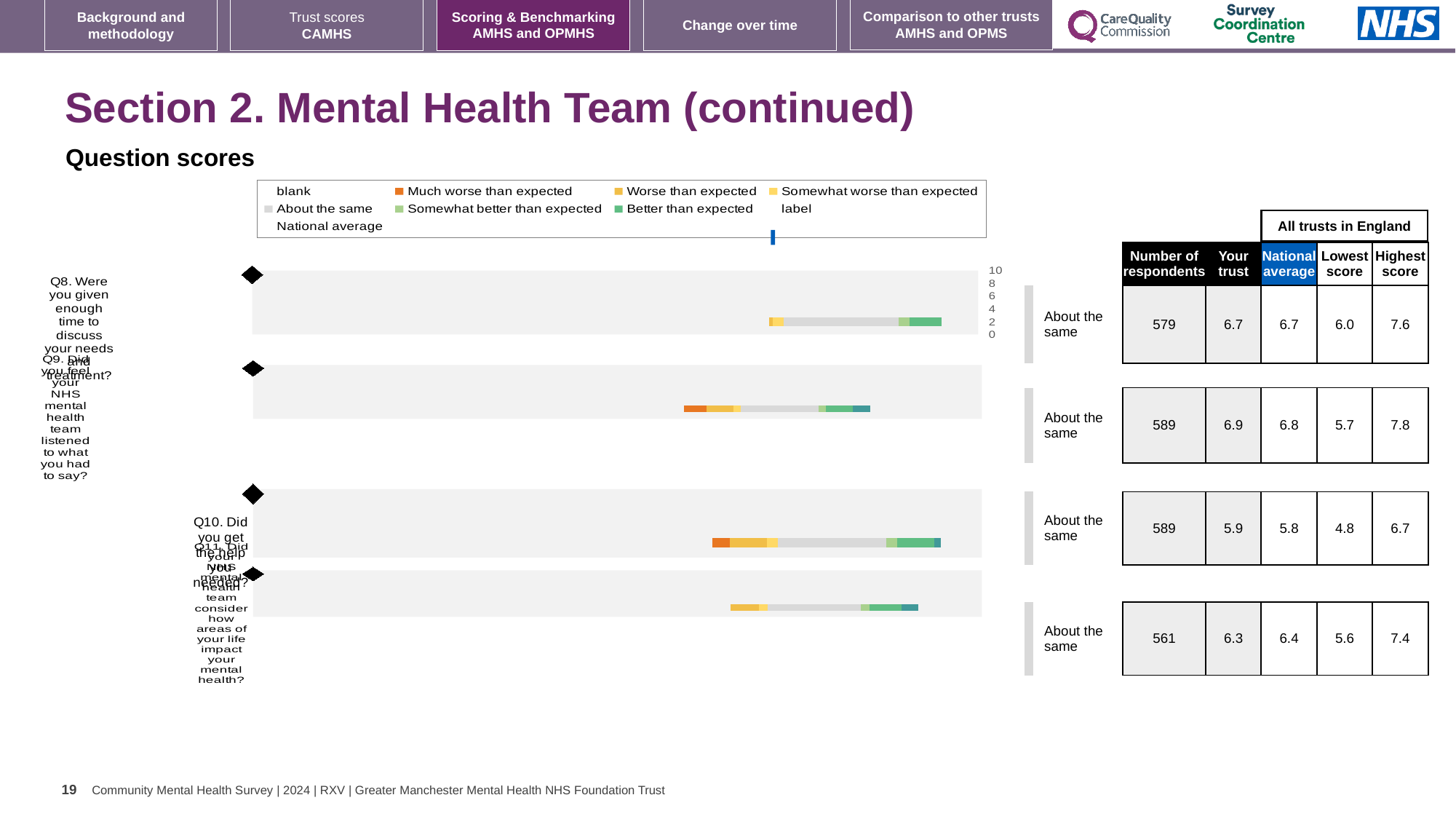
In the table beside the chart, what is the highest score across all trusts in England for Q11? 7.4 How many questions (Q8 to Q11) are plotted in the chart? 4 In the table beside the chart, what is the national average for Q10? 5.8 In the table beside the chart, what is the 'Your trust' score for Q9? 6.9 What colour in the legend represents 'Much worse than expected'? Orange For Q11, which is larger: the 'Your trust' score or the national average? National average Which question has the lowest 'Your trust' score in the table? Q10 In the table beside the chart, what is the number of respondents for Q8? 579 What kind of chart is used to show the question scores? bar chart For Q9, what is the difference between the highest score (7.8) and the lowest score (5.7) across all trusts in England? 2.1 How many entries does the chart legend list? 9 Which question has the highest 'Your trust' score in the table? Q9